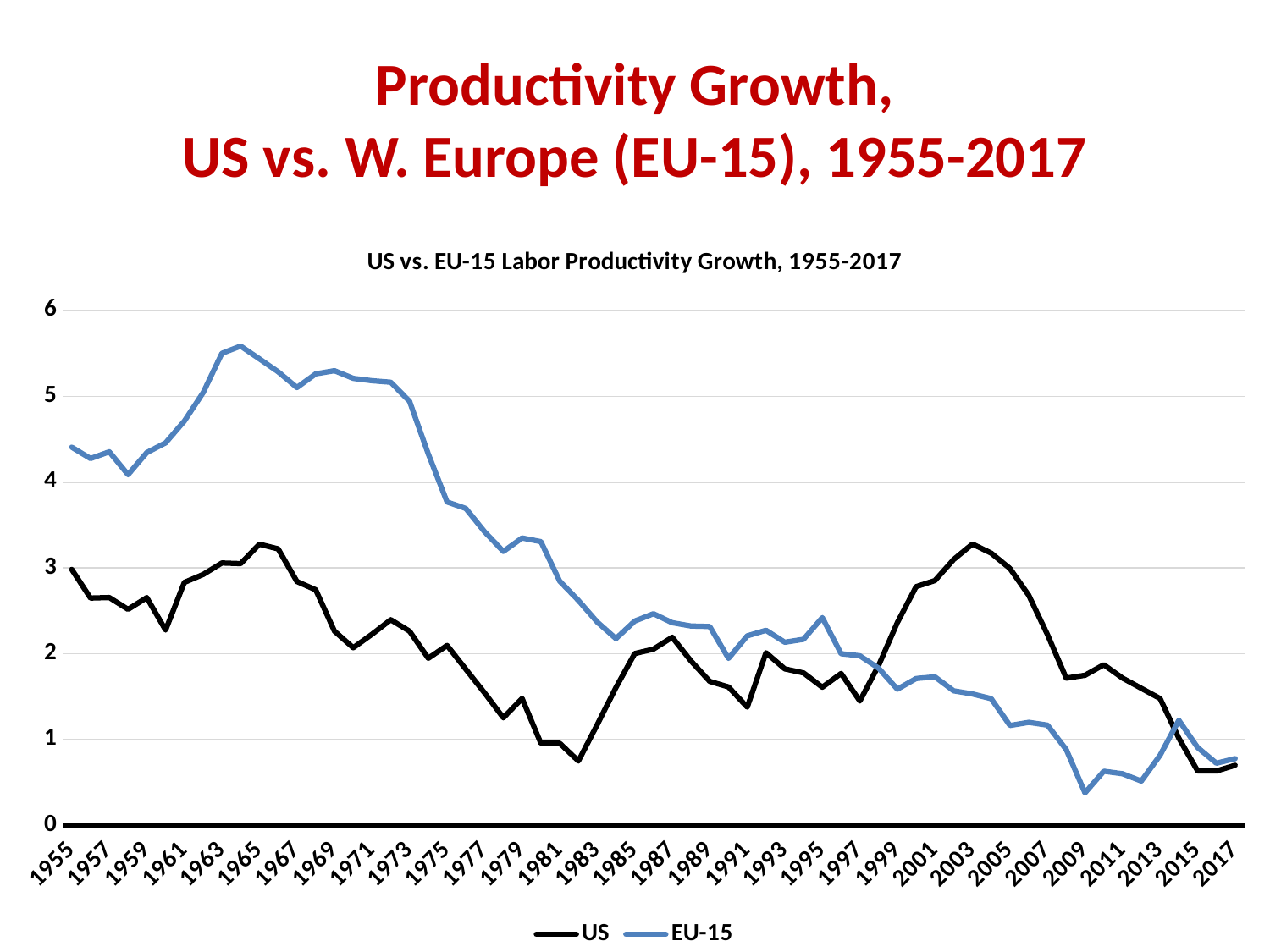
What kind of chart is shown on the slide? line chart Is the EU-15 value for 1965 greater or less than 5? greater In 1965, which series has the higher value, US or EU-15? EU-15 Is the US value for 2003 greater or less than 3? greater Is the US value for 1983 greater or less than 1? greater How many series does the legend list? 2 In 2003, which series has the higher value, US or EU-15? US In which year does the EU-15 line reach its lowest value? 2009 Which colour is used for the EU-15 line? blue What is the title printed above the chart? US vs. EU-15 Labor Productivity Growth, 1955-2017